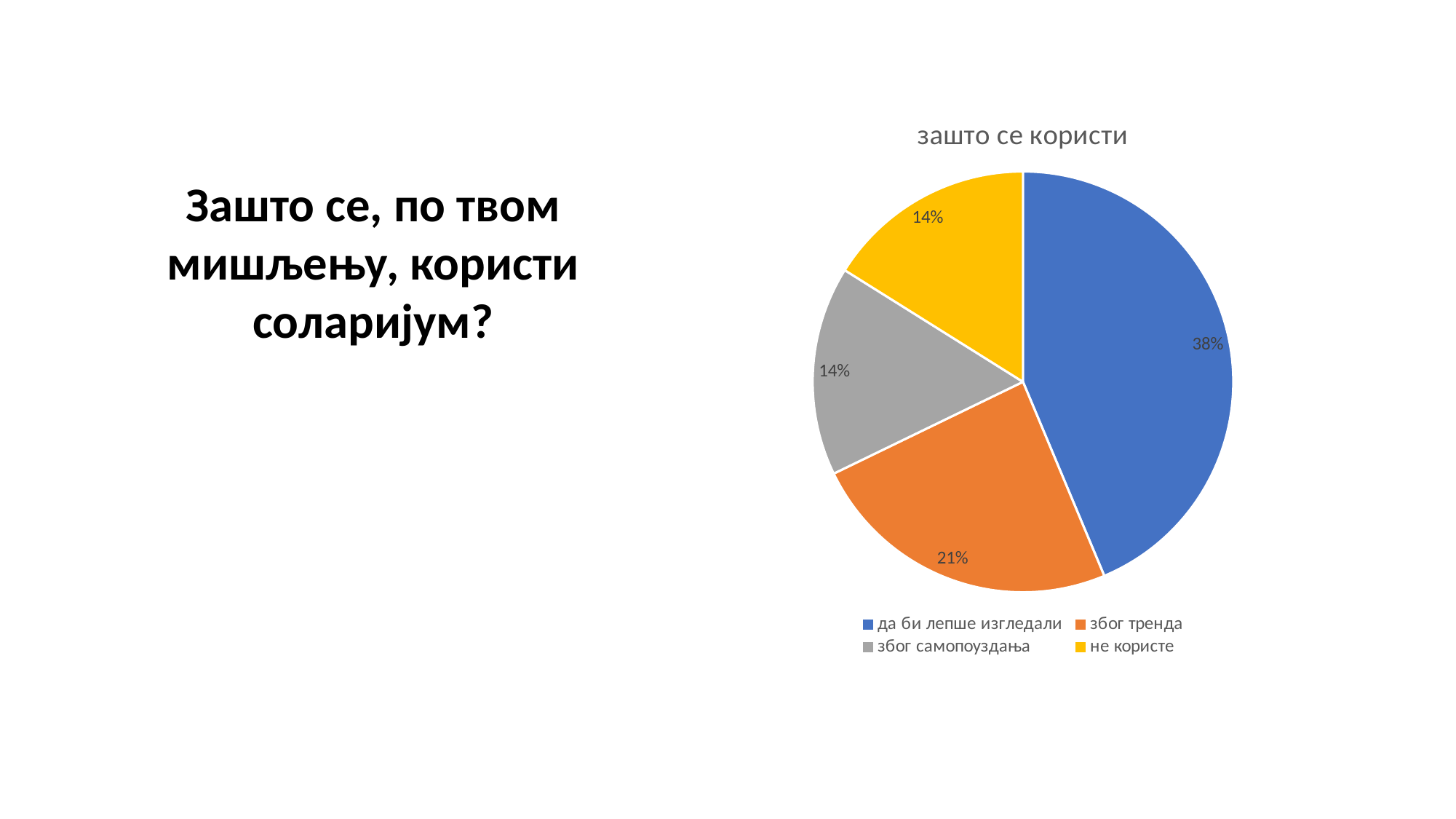
Which category has the largest slice of the pie? да би лепше изгледали Which colour is used for the "не користе" slice? yellow What share of the pie does "да би лепше изгледали" take? 38% How many slices does the pie chart have? 4 What is the difference in percentage points between "због тренда" and "због самопоуздања"? 7 What is the title of the chart? зашто се користи What share of the pie does "због тренда" take? 21% What is the difference in percentage points between "да би лепше изгледали" and "због тренда"? 17 What kind of chart is shown on the slide? pie chart Which is larger, the slice for "због тренда" or the slice for "не користе"? због тренда What share of the pie does "не користе" take? 14%